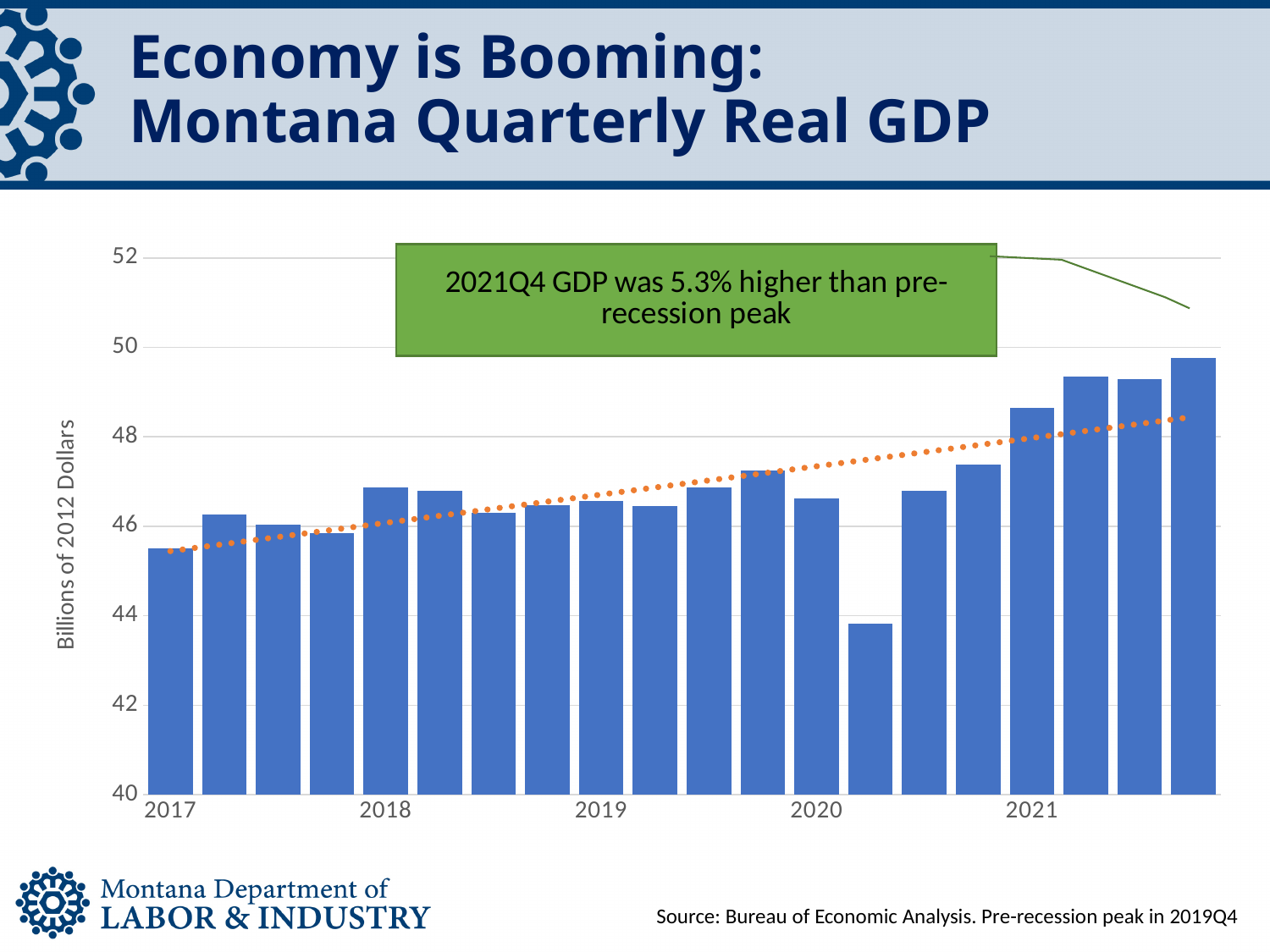
How many year labels appear on the x axis of the chart? 5 What kind of chart is shown on the slide? bar chart According to the annotation on the chart, how much higher was 2021Q4 GDP than the pre-recession peak? 5.3% What is the label on the y axis of the chart? Billions of 2012 Dollars Which quarter has the highest real GDP in the chart? 2021 Q4 Is the value for the second quarter of 2020 greater or less than 44? less Which quarter has the lowest real GDP in the chart? 2020 Q2 Overall, do the GDP values rise or fall from 2017 to 2021? rise Is the value for the last bar (2021 Q4) greater or less than 48? greater Which is larger, the value for the first quarter of 2021 or the second quarter of 2020? first quarter of 2021 Is the value for the first bar (2017 Q1) greater or less than 46? less How many bars (quarters) are plotted in the chart? 20